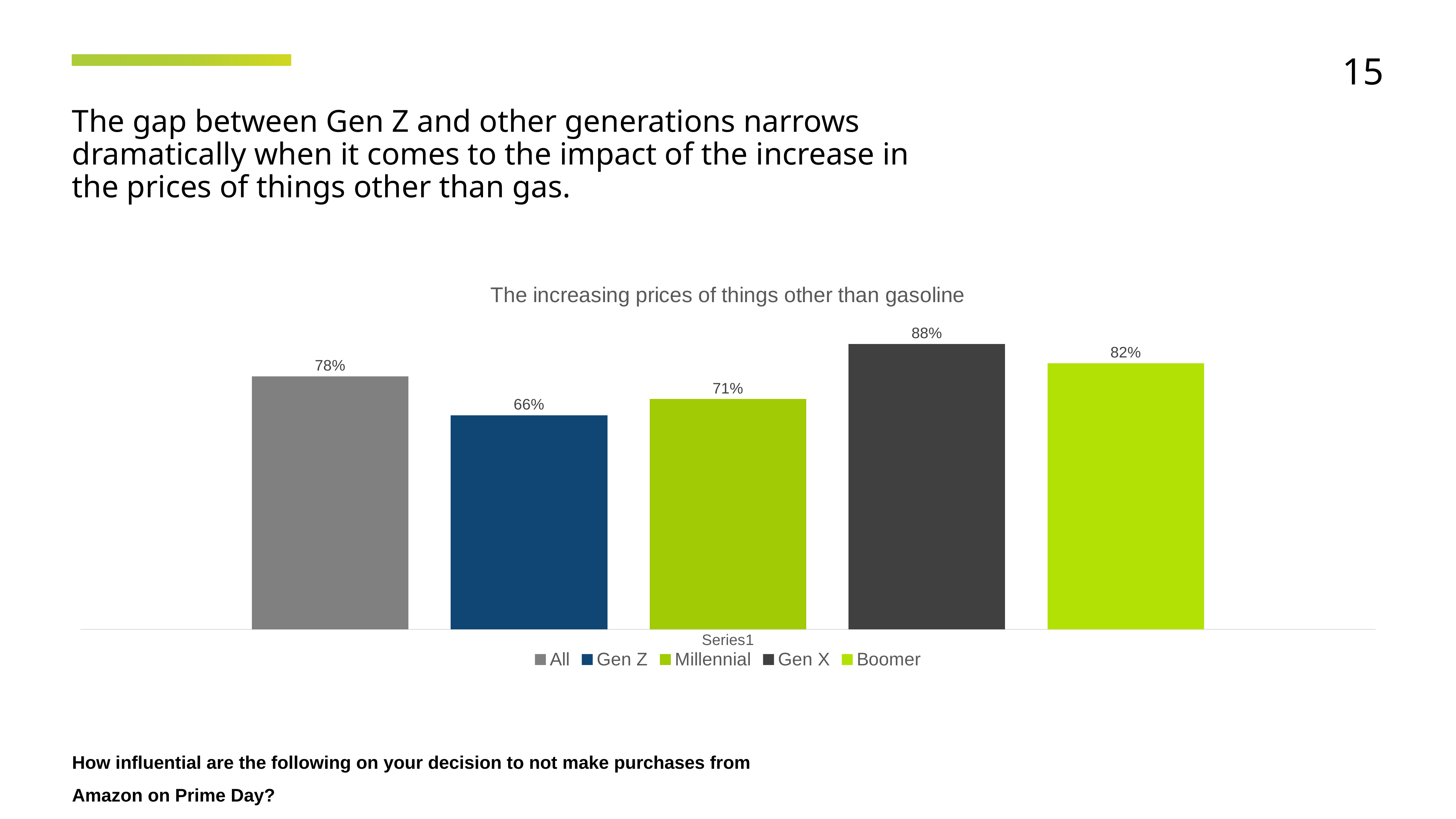
What kind of chart is shown? Bar chart What is the difference between the Gen X and Gen Z values? 22% Which group has the lowest value? Gen Z Which is larger, the value for Millennial or the value for All? All Which group has the highest value? Gen X What is the value for Boomer? 82% What is the value for Gen Z? 66% What is the title of the chart? The increasing prices of things other than gasoline What is the difference between the Boomer and Millennial values? 11% What is the value for All? 78% How many series does the legend list? 5 What is the value for Gen X? 88%